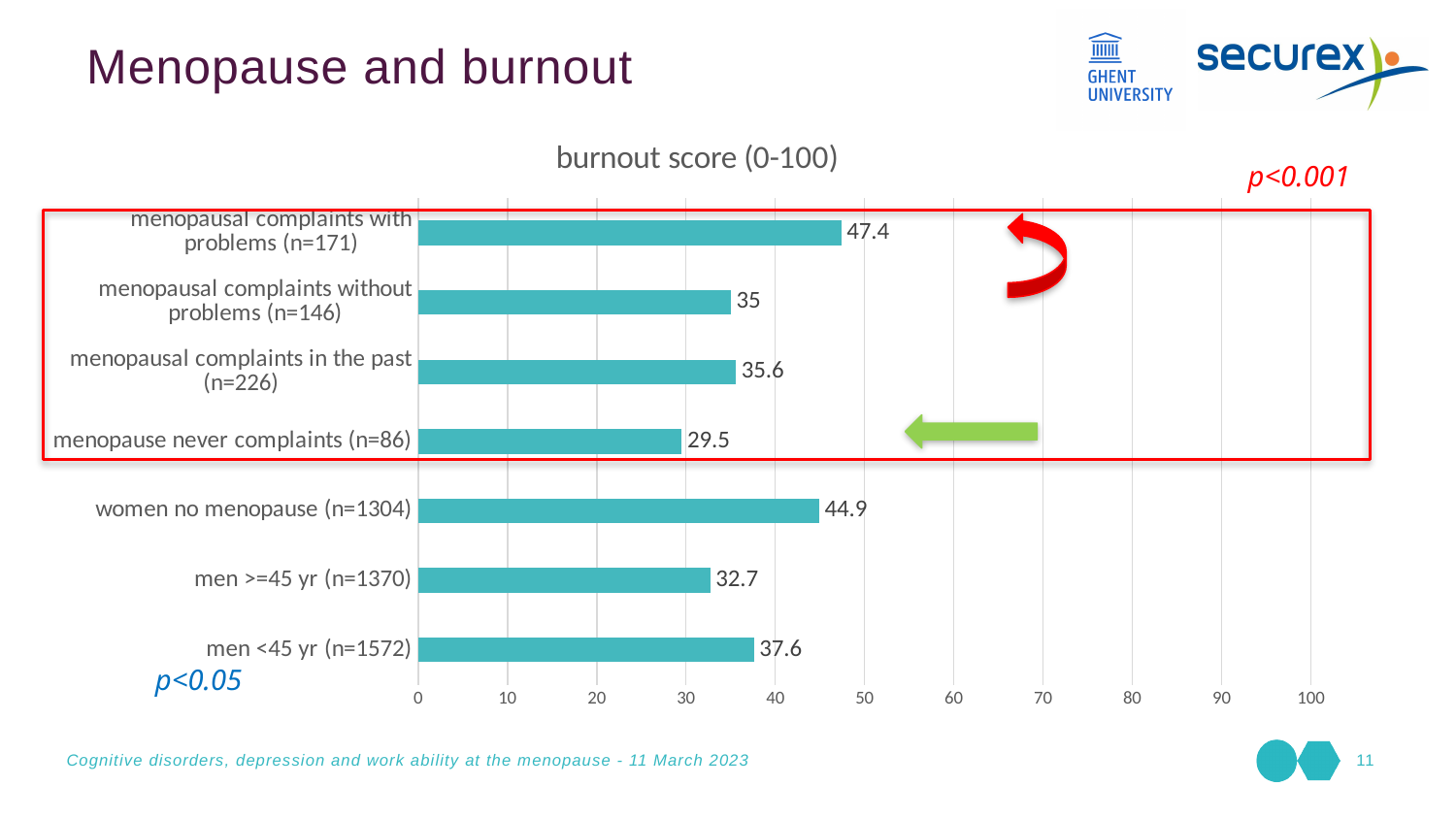
What is the burnout score for menopausal complaints with problems (n=171)? 47.4 What is the difference in burnout score between menopausal complaints with problems (n=171) and menopause never complaints (n=86)? 17.9 What is the burnout score for men <45 yr (n=1572)? 37.6 Which category has the lowest burnout score? menopause never complaints (n=86) Which has a higher burnout score: menopausal complaints without problems (n=146) or menopausal complaints in the past (n=226)? menopausal complaints in the past (n=226) What is the burnout score for women no menopause (n=1304)? 44.9 Is the burnout score for women no menopause (n=1304) greater or less than 40? greater What is the difference in burnout score between men <45 yr (n=1572) and men >=45 yr (n=1370)? 4.9 How many categories are shown in the chart? 7 Which category has the highest burnout score? menopausal complaints with problems (n=171) What kind of chart is shown on the slide? bar chart What is the title of the chart? burnout score (0-100)